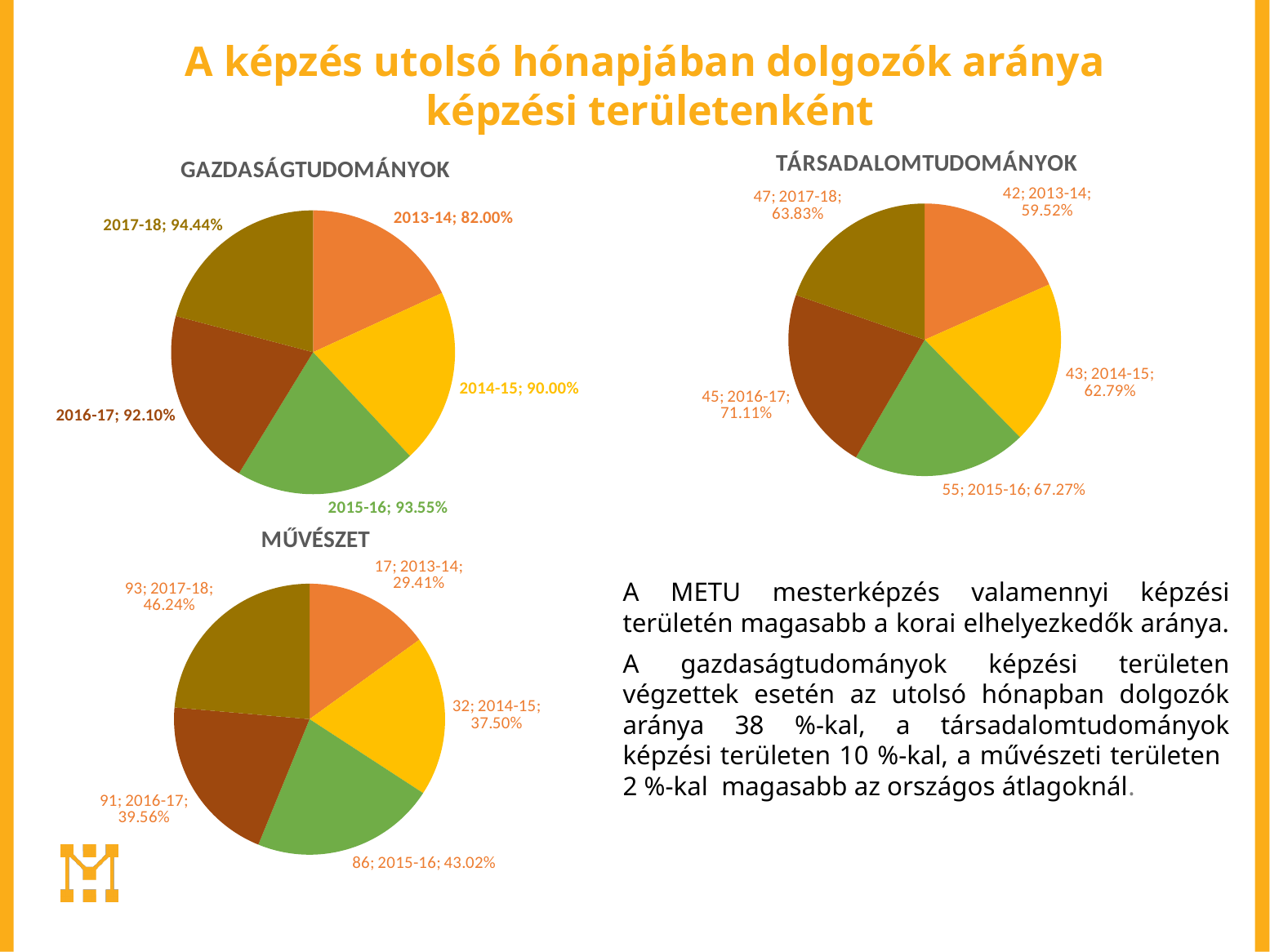
In the TÁRSADALOMTUDOMÁNYOK chart, what percentage is shown for 2016-17? 71.11% In the GAZDASÁGTUDOMÁNYOK chart, what is the difference between the percentages for 2017-18 and 2013-14? 12.44 percentage points In the TÁRSADALOMTUDOMÁNYOK chart, what count is shown for 2015-16? 55 In the GAZDASÁGTUDOMÁNYOK chart, what percentage is shown for 2017-18? 94.44% How many slices does the MŰVÉSZET pie chart have? 5 In the MŰVÉSZET chart, which is larger, the percentage for 2014-15 or for 2016-17? 2016-17 In the TÁRSADALOMTUDOMÁNYOK chart, which year has the highest percentage label? 2016-17 In the GAZDASÁGTUDOMÁNYOK chart, what percentage is shown for 2013-14? 82.00% What type of chart is used for GAZDASÁGTUDOMÁNYOK? Pie chart In the MŰVÉSZET chart, which year has the lowest percentage label? 2013-14 In the GAZDASÁGTUDOMÁNYOK chart, which year has the lowest percentage label? 2013-14 In the MŰVÉSZET chart, what percentage is shown for 2015-16? 43.02%